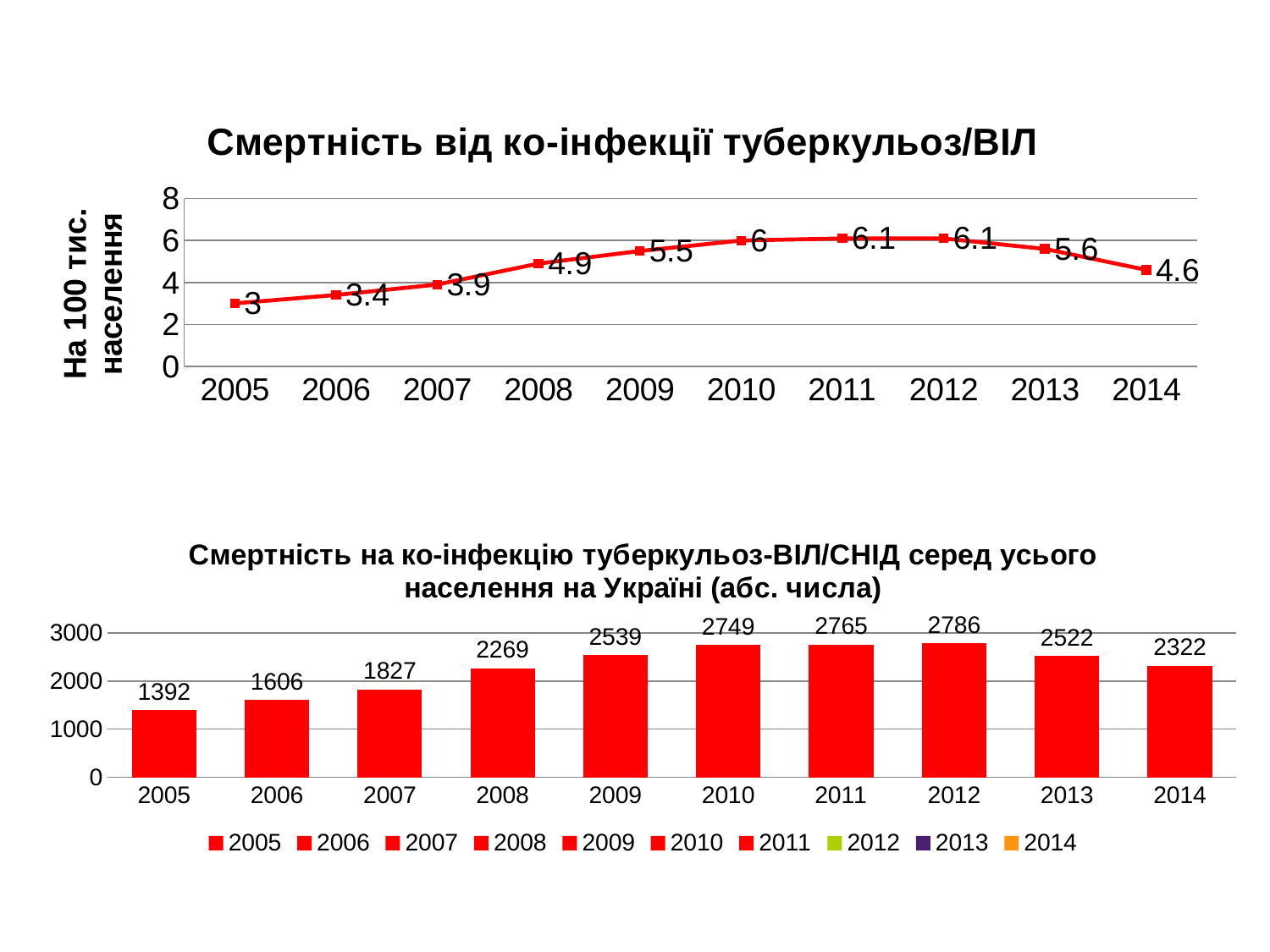
In the bottom chart (Смертність на ко-інфекцію туберкульоз-ВІЛ/СНІД серед усього населення на Україні), which year has the highest value? 2012 In the bottom chart (Смертність на ко-інфекцію туберкульоз-ВІЛ/СНІД серед усього населення на Україні), which year has the lowest value? 2005 In the top chart (Смертність від ко-інфекції туберкульоз/ВІЛ), what is the value for 2008? 4.9 In the top chart (Смертність від ко-інфекції туберкульоз/ВІЛ), which year has the lowest value? 2005 In the top chart (Смертність від ко-інфекції туберкульоз/ВІЛ), do the values rise or fall from 2005 to 2010? rise In the bottom chart (Смертність на ко-інфекцію туберкульоз-ВІЛ/СНІД серед усього населення на Україні), what is the difference between the values for 2012 and 2005? 1394 In the top chart (Смертність від ко-інфекції туберкульоз/ВІЛ), what is the value for 2014? 4.6 In the bottom chart (Смертність на ко-інфекцію туберкульоз-ВІЛ/СНІД серед усього населення на Україні), how many entries does the legend list? 10 In the top chart (Смертність від ко-інфекції туберкульоз/ВІЛ), what is the difference between the values for 2012 and 2014? 1.5 In the bottom chart (Смертність на ко-інфекцію туберкульоз-ВІЛ/СНІД серед усього населення на Україні), which is larger, the value for 2013 or the value for 2014? 2013 In the bottom chart (Смертність на ко-інфекцію туберкульоз-ВІЛ/СНІД серед усього населення на Україні), what is the value for 2009? 2539 In the top chart (Смертність від ко-інфекції туберкульоз/ВІЛ), what kind of chart is shown? line chart